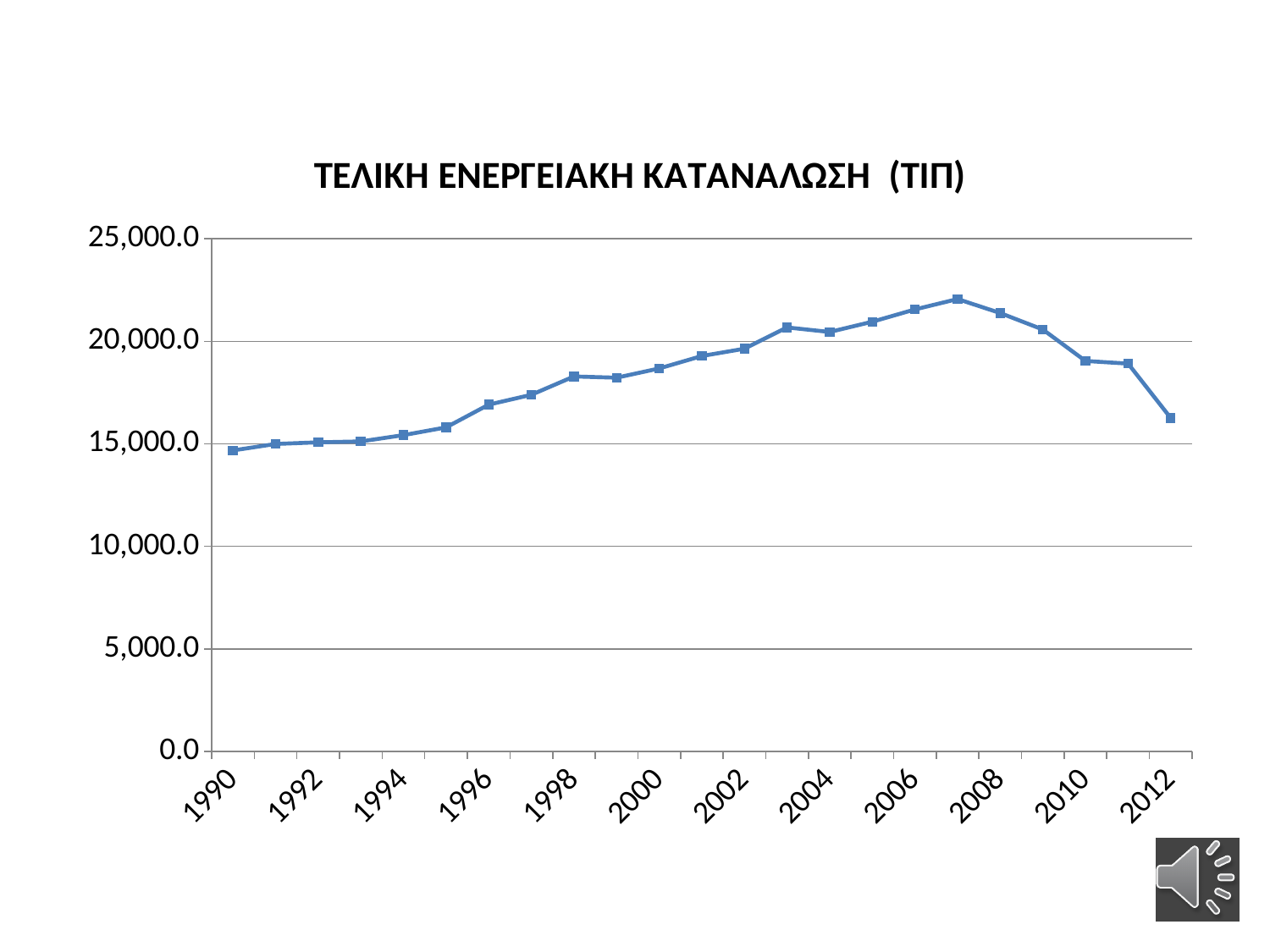
In which year is the value highest? 2007 Is the value for 1990 greater or less than 15,000.0? less In which year is the value lowest? 1990 Do the values generally rise or fall from 2007 to 2012? fall How many data points are plotted on the line? 23 Is the value for 2007 greater or less than 20,000.0? greater Which year has the larger value, 1990 or 2000? 2000 Is the value for 2000 greater or less than 20,000.0? less What is the title of the chart? ΤΕΛΙΚΗ ΕΝΕΡΓΕΙΑΚΗ ΚΑΤΑΝΑΛΩΣΗ (ΤΙΠ) What kind of chart is shown on the slide? line chart Which year has the larger value, 2007 or 2012? 2007